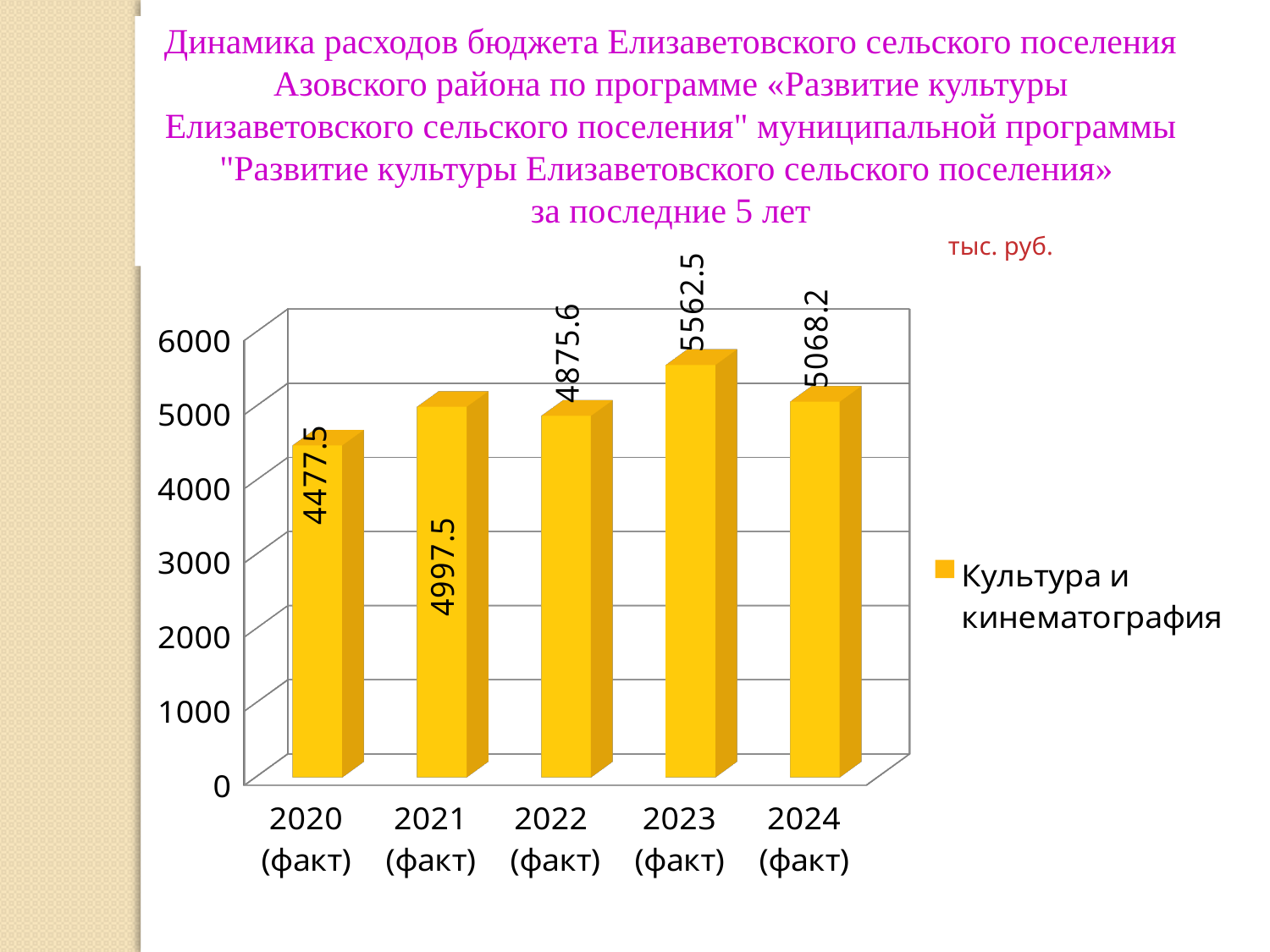
Which year has the highest value? 2023 (факт) Which is larger, the value for 2021 (факт) or the value for 2022 (факт)? 2021 (факт) What is the value for 2023 (факт)? 5562.5 What is the difference between the values for 2023 (факт) and 2020 (факт)? 1085 What is the value for 2020 (факт)? 4477.5 What kind of chart is shown on the slide? bar chart How many years are shown on the x axis? 5 Which year has the lowest value? 2020 (факт) Is the value for 2020 (факт) greater or less than 5000? less What is the difference between the values for 2021 (факт) and 2022 (факт)? 121.9 What is the value for 2024 (факт)? 5068.2 What series name does the legend show? Культура и кинематография